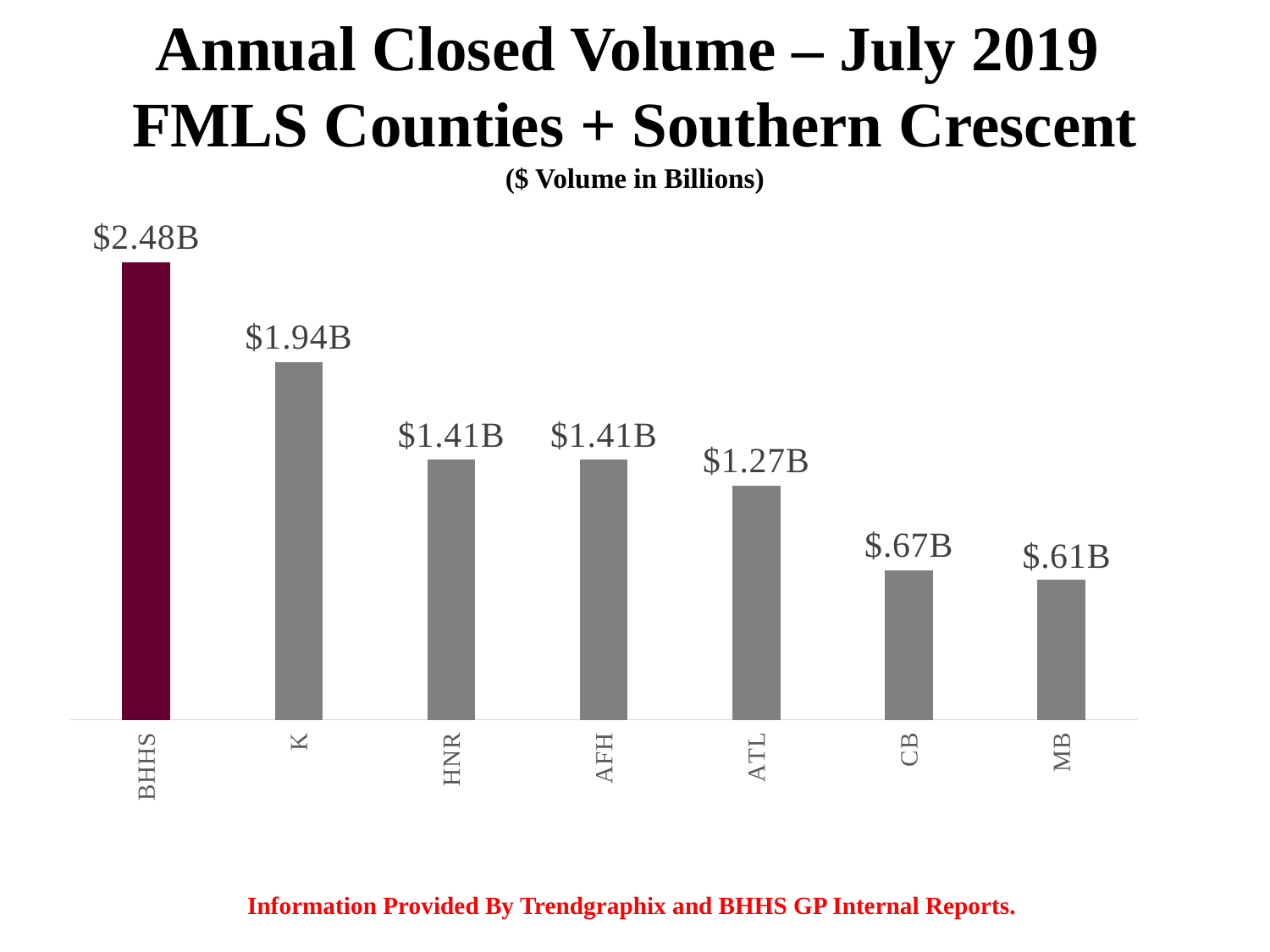
Which category has the lowest annual closed volume? MB What is the difference between the closed volume for CB and MB? $.06B What kind of chart is shown on the slide? Bar chart What is the annual closed volume for K? $1.94B What is the annual closed volume for ATL? $1.27B What is the annual closed volume for BHHS? $2.48B Which has a larger closed volume, ATL or CB? ATL What is the difference between the closed volume for BHHS and K? $.54B Which category has the highest annual closed volume? BHHS What is the annual closed volume for MB? $.61B How many categories are shown in the chart? 7 Which bar is shown in a different colour from the others? BHHS